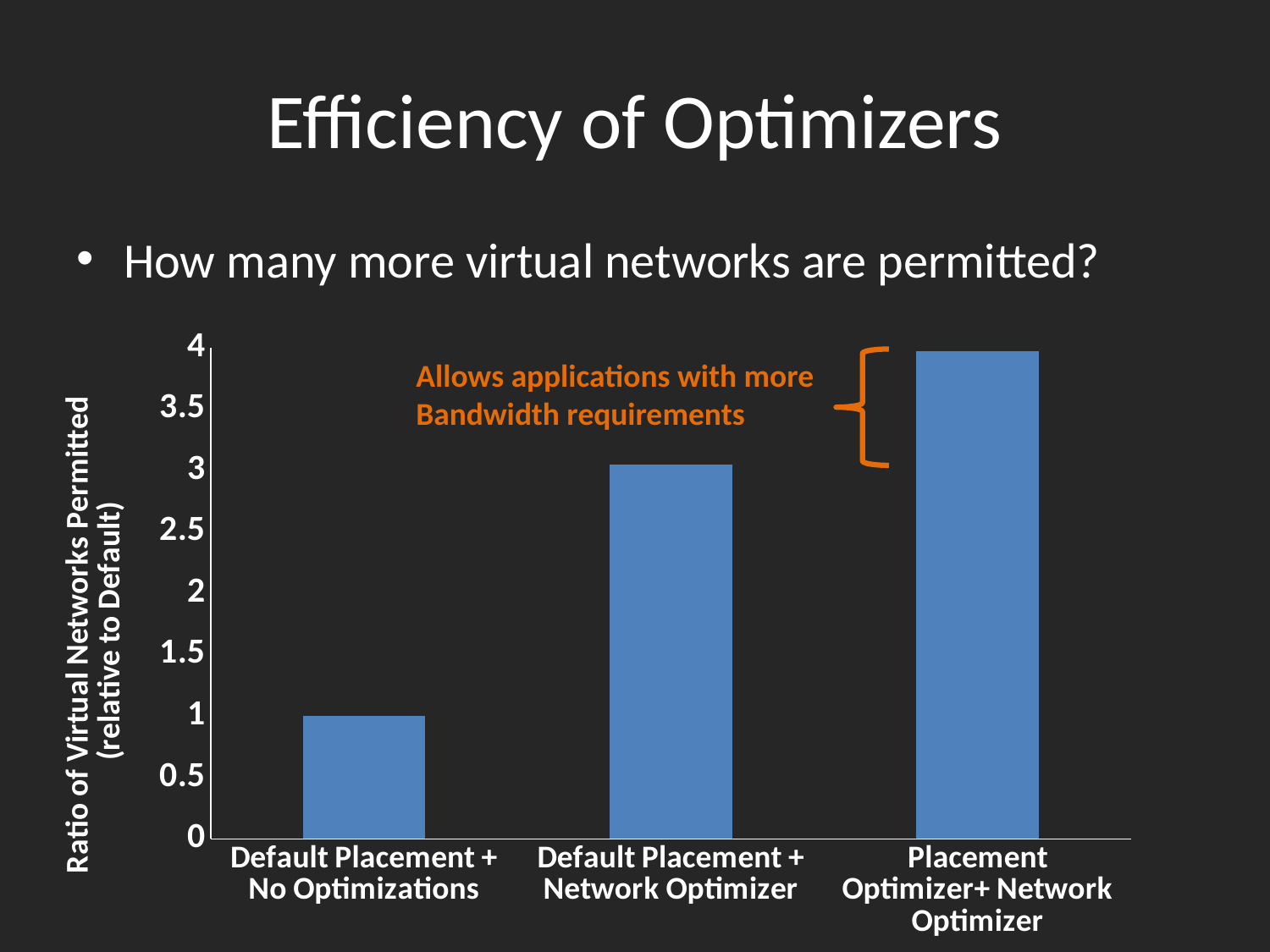
Is the value for Default Placement + Network Optimizer greater or less than 2? greater Which is larger, the value for Default Placement + Network Optimizer or the value for Placement Optimizer+ Network Optimizer? Placement Optimizer+ Network Optimizer Which category has the highest ratio of virtual networks permitted? Placement Optimizer+ Network Optimizer Which category has the lowest ratio of virtual networks permitted? Default Placement + No Optimizations What is the value for Default Placement + No Optimizations? 1 What is the label of the y axis of the chart? Ratio of Virtual Networks Permitted (relative to Default) Do the values rise or fall from left to right along the x axis? rise What kind of chart is shown on the slide? bar chart Is the value for Placement Optimizer+ Network Optimizer greater or less than 3.5? greater How many categories are shown on the x axis of the chart? 3